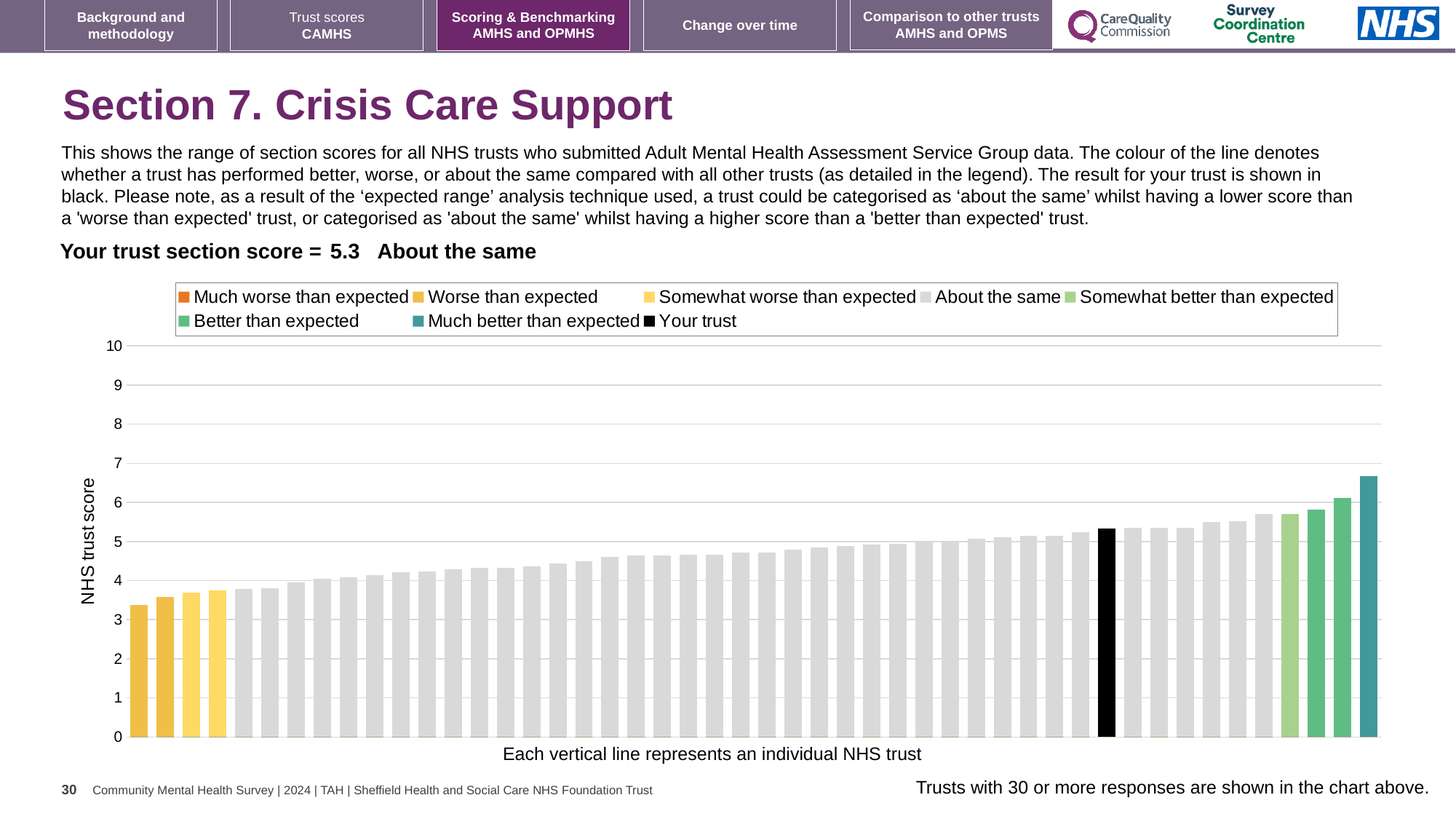
Which category is your trust's section score placed in? About the same Do the bar values rise or fall from left to right along the x axis? rise Is the value for the shortest bar greater or less than 4? less What is the section score for your trust? 5.3 What is the label on the y axis of the chart? NHS trust score Which legend category does the tallest bar belong to? Much better than expected How many series does the legend list? 8 Is the value for the black 'Your trust' bar greater or less than 5? greater What kind of chart is shown on the slide? bar chart Is the value for the tallest bar greater or less than 6? greater How many bars are coloured as 'Much better than expected'? 1 Which legend category does the shortest bar belong to? Worse than expected